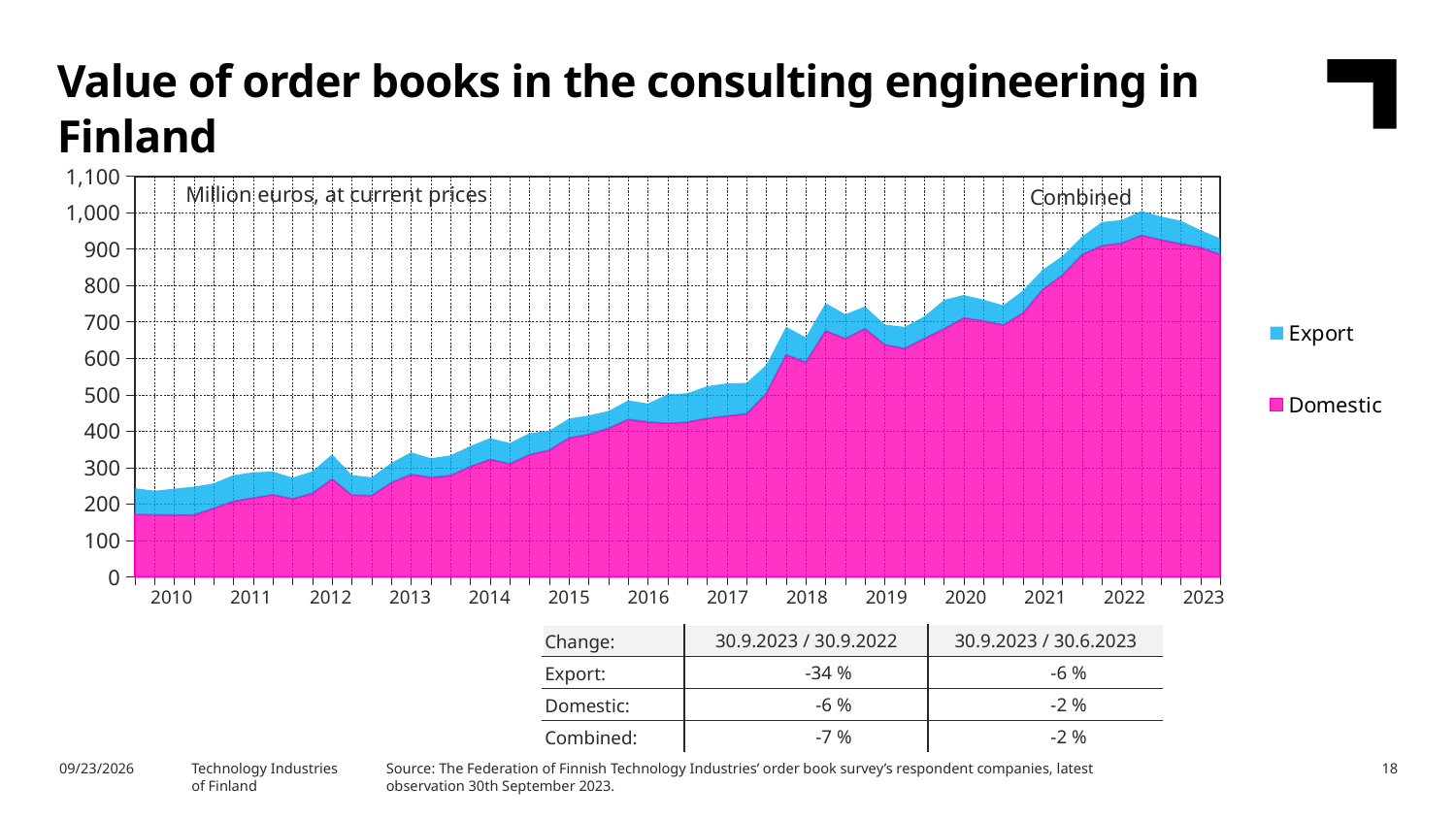
Is the combined value of order books at the start of 2020 greater or less than 600? greater Is the combined value of order books in 2023 greater or less than 800? greater What unit is stated in the label inside the chart area? Million euros, at current prices Which two series are listed in the chart's legend? Export and Domestic What kind of chart is shown on the slide? Stacked area chart How many years are labelled on the x axis of the chart? 14 Which series makes up the larger part of the combined value in 2023, Export or Domestic? Domestic How many series does the chart's legend list? 2 Is the Domestic value at the start of 2010 greater or less than 200? less Does the combined value of order books generally rise or fall from 2010 to 2023? rise